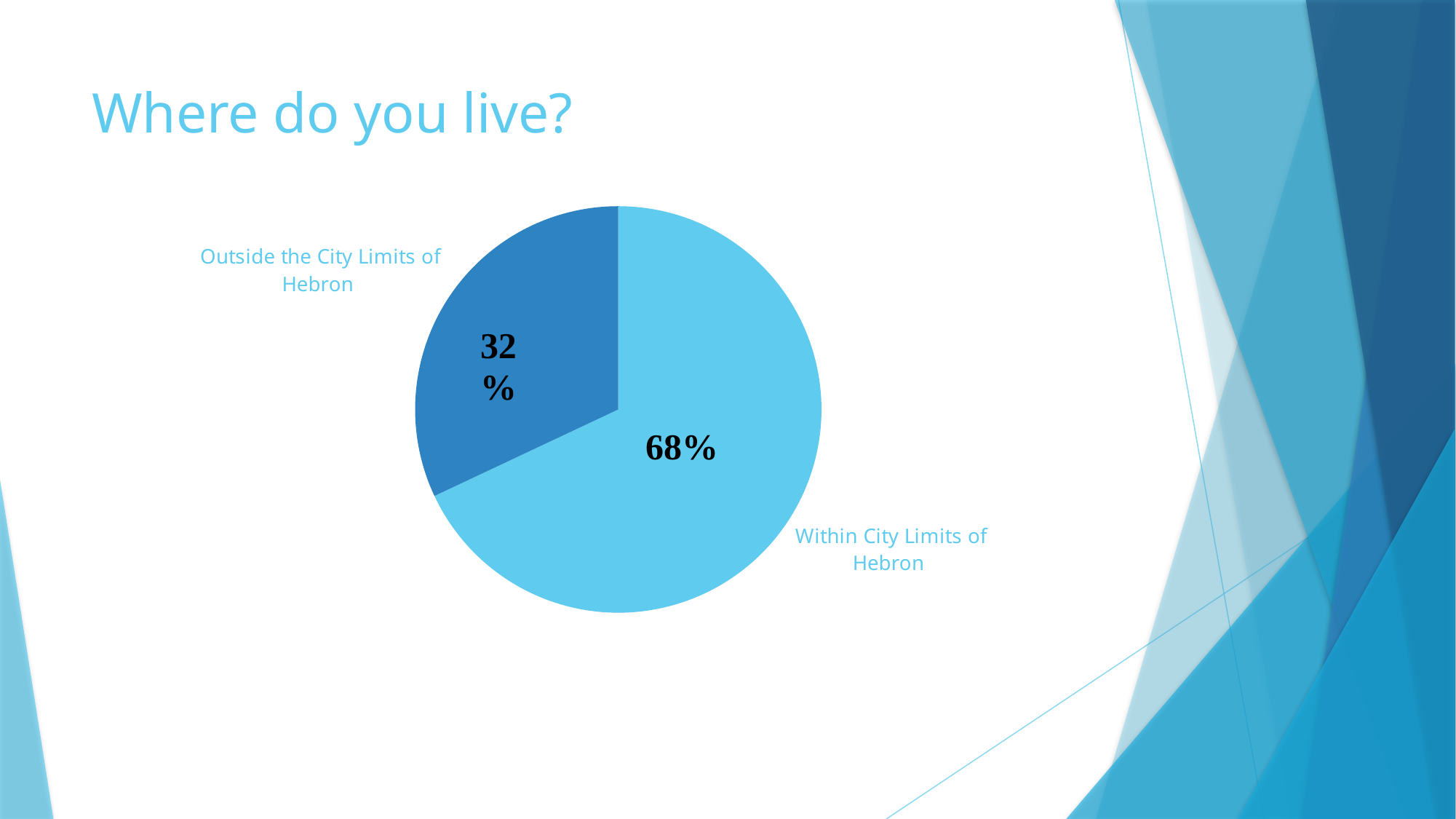
How many slices does the pie chart have? 2 Which is larger: the share for Within City Limits of Hebron or the share for Outside the City Limits of Hebron? Within City Limits of Hebron What is the title of the slide containing the pie chart? Where do you live? What is the difference in percentage points between the Within City Limits of Hebron slice and the Outside the City Limits of Hebron slice? 36 What kind of chart is shown on the slide? pie chart What percentage of respondents live within the city limits of Hebron? 68% What share of the pie does the Outside the City Limits of Hebron slice represent? 32% Which slice is shown in the darker blue colour? Outside the City Limits of Hebron Which category has the smallest share of the pie? Outside the City Limits of Hebron What percentage of respondents live outside the city limits of Hebron? 32% Which category has the largest share of the pie? Within City Limits of Hebron